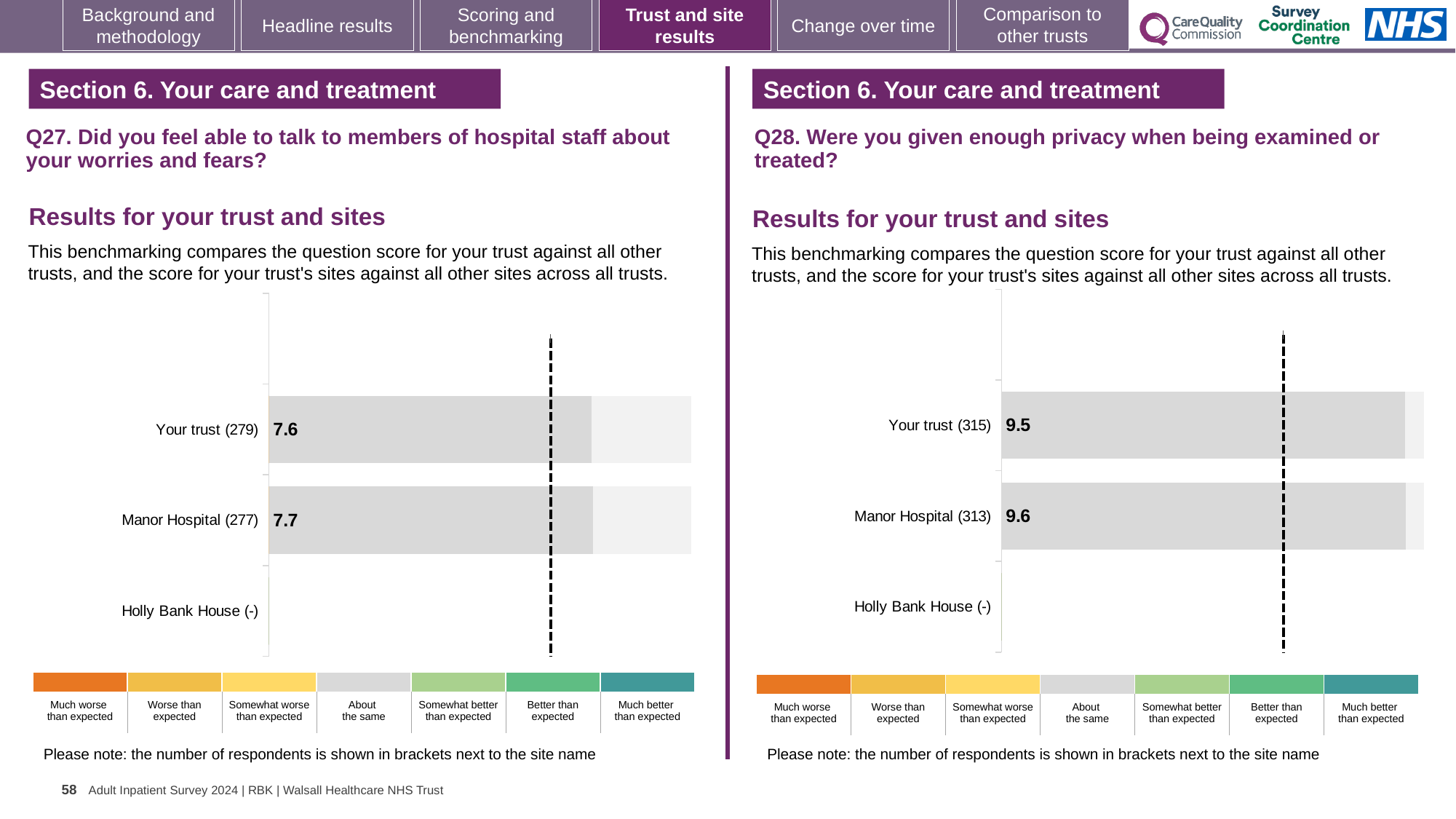
In the Q28 chart on the right, what is the difference between the Manor Hospital score and the Your trust score? 0.1 In the Q27 chart on the left, which category has no score shown? Holly Bank House In the Q28 chart on the right, what is the score for Manor Hospital? 9.6 In the Q28 chart on the right, how many respondents are shown in brackets for Your trust? 315 In the Q27 chart on the left, how many respondents are shown in brackets for Manor Hospital? 277 What type of chart is used in the Q28 chart on the right? Bar chart In the Q27 chart on the left, what is the score for Your trust? 7.6 In the Q28 chart on the right, which has the higher score, Your trust or Manor Hospital? Manor Hospital In the Q28 chart on the right, what is the score for Your trust? 9.5 In the Q27 chart on the left, what is the difference between the Manor Hospital score and the Your trust score? 0.1 In the Q27 chart on the left, what is the score for Manor Hospital? 7.7 In the Q27 chart on the left, how many site or trust categories are listed on the vertical axis? 3